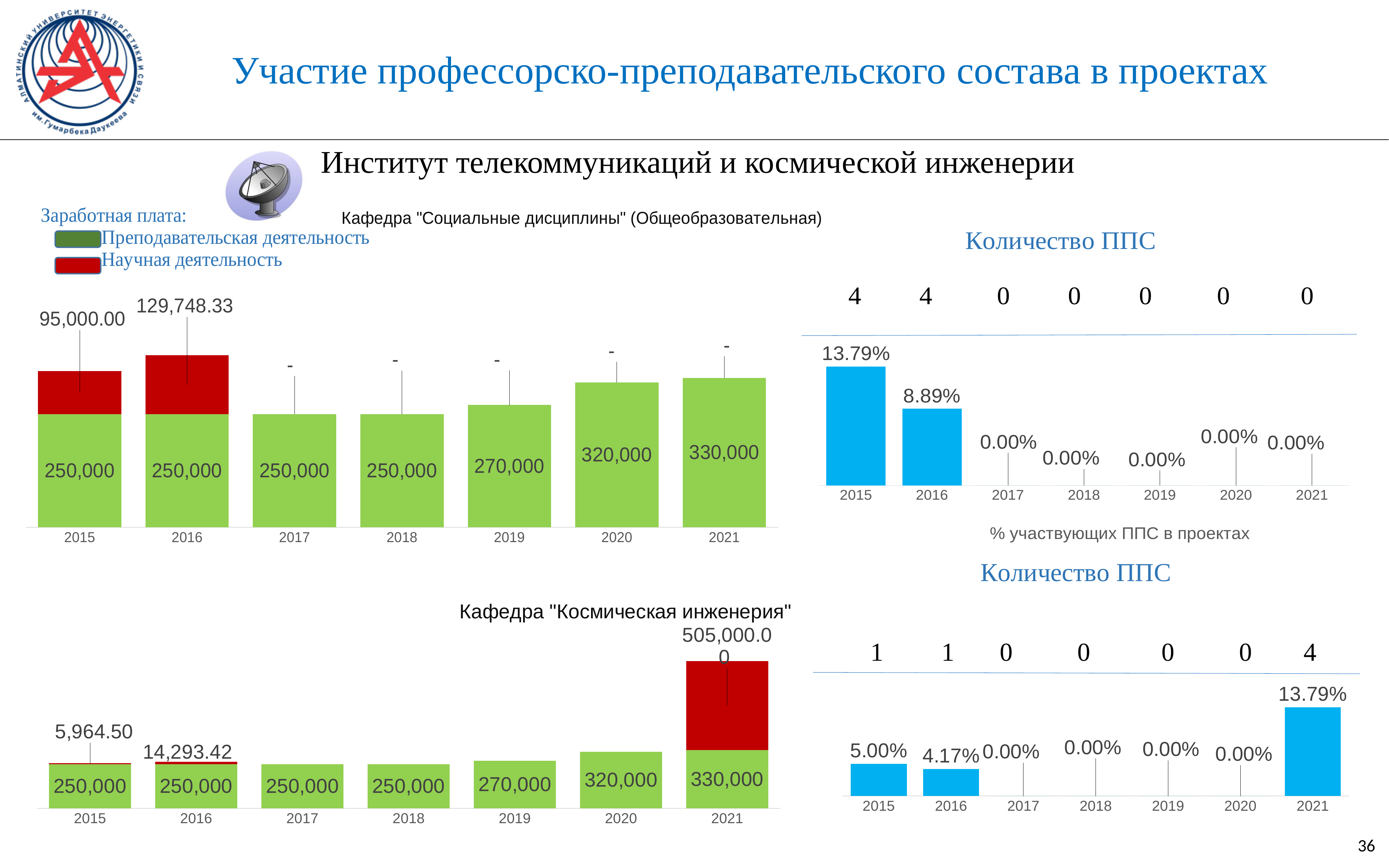
In the salary chart for Кафедра "Социальные дисциплины", what is the value of Научная деятельность for 2016? 129,748.33 In the salary chart for Кафедра "Космическая инженерия", what is the difference between the Научная деятельность values for 2016 and 2015? 8,328.92 In the bottom-right chart (% участвующих ППС в проектах for Кафедра "Космическая инженерия"), which is larger, the value for 2015 or 2016? 2015 In the bottom-right chart (% участвующих ППС в проектах for Кафедра "Космическая инженерия"), what is the value for 2021? 13.79% How many years are shown on the x axis of the salary chart for Кафедра "Социальные дисциплины"? 7 In the salary chart for Кафедра "Космическая инженерия", which year has the highest Научная деятельность value? 2021 In the salary chart for Кафедра "Космическая инженерия", what is the value of Научная деятельность for 2021? 505,000.00 In the salary chart for Кафедра "Космическая инженерия", does the Преподавательская деятельность value rise or fall from 2018 to 2021? rise In the salary chart for Кафедра "Социальные дисциплины", what is the total of the stacked bar for 2015? 345,000.00 In the top-right chart (% участвующих ППС в проектах for Кафедра "Социальные дисциплины"), what is the value for 2016? 8.89% In the salary chart for Кафедра "Социальные дисциплины", what is the value of Преподавательская деятельность for 2020? 320,000 In the top-right chart (% участвующих ППС в проектах for Кафедра "Социальные дисциплины"), which year has the highest value? 2015